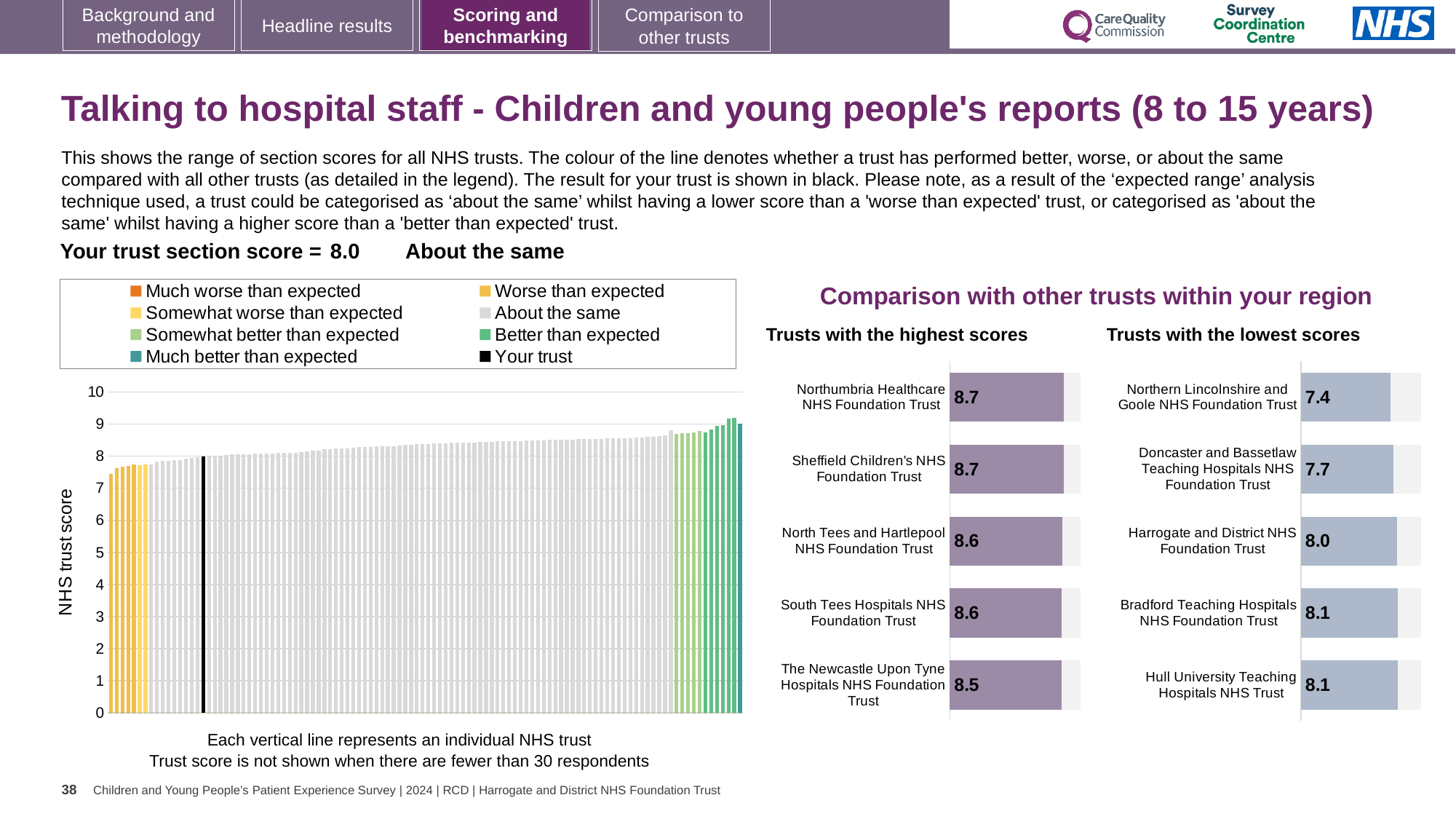
In the 'Trusts with the lowest scores' chart, which trust has the lowest score? Northern Lincolnshire and Goole NHS Foundation Trust In the 'Trusts with the highest scores' chart, what is the score for North Tees and Hartlepool NHS Foundation Trust? 8.6 In the 'Trusts with the lowest scores' chart, which has the higher score: Doncaster and Bassetlaw Teaching Hospitals NHS Foundation Trust or Harrogate and District NHS Foundation Trust? Harrogate and District NHS Foundation Trust In the 'Trusts with the lowest scores' chart, what is the score for Northern Lincolnshire and Goole NHS Foundation Trust? 7.4 In the 'Trusts with the highest scores' chart, which trust has the lowest score shown? The Newcastle Upon Tyne Hospitals NHS Foundation Trust In the 'Trusts with the highest scores' chart, what is the difference between the scores of Northumbria Healthcare NHS Foundation Trust and The Newcastle Upon Tyne Hospitals NHS Foundation Trust? 0.2 In the large chart on the left showing all NHS trusts, do the bar values rise or fall from left to right? rise How many trusts are listed in the 'Trusts with the highest scores' chart? 5 What kind of chart is the large chart on the left showing all NHS trusts? bar chart In the 'Trusts with the lowest scores' chart, what is the difference between the scores of Harrogate and District NHS Foundation Trust and Northern Lincolnshire and Goole NHS Foundation Trust? 0.6 How many entries does the legend of the large chart on the left list? 8 In the large chart on the left showing all NHS trusts, is the value for the black 'Your trust' bar greater or less than 9? less